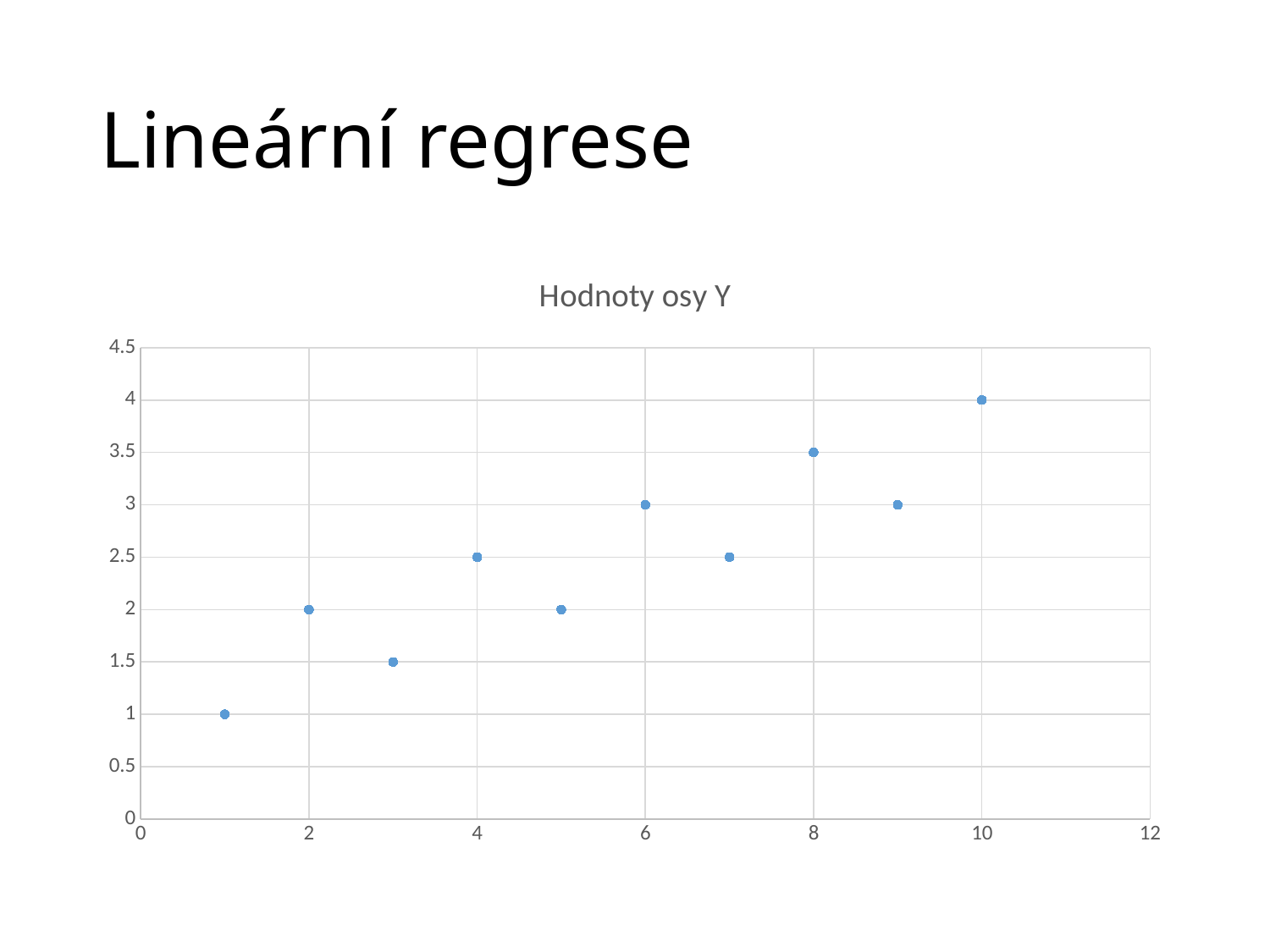
What is the y value of the point at x = 3? 1.5 Do the y values generally rise or fall as x increases? rise What is the difference between the y values at x = 10 and x = 1? 3 At which x value does the point with the highest y value occur? 10 What kind of chart is shown on the slide? scatter chart What is the y value of the point at x = 10? 4 What is the y value of the point at x = 1? 1 At which x value does the point with the lowest y value occur? 1 What is the title of the chart? Hodnoty osy Y Which point has a larger y value, the one at x = 6 or the one at x = 7? x = 6 How many data points are plotted in the chart? 10 What is the y value of the point at x = 8? 3.5